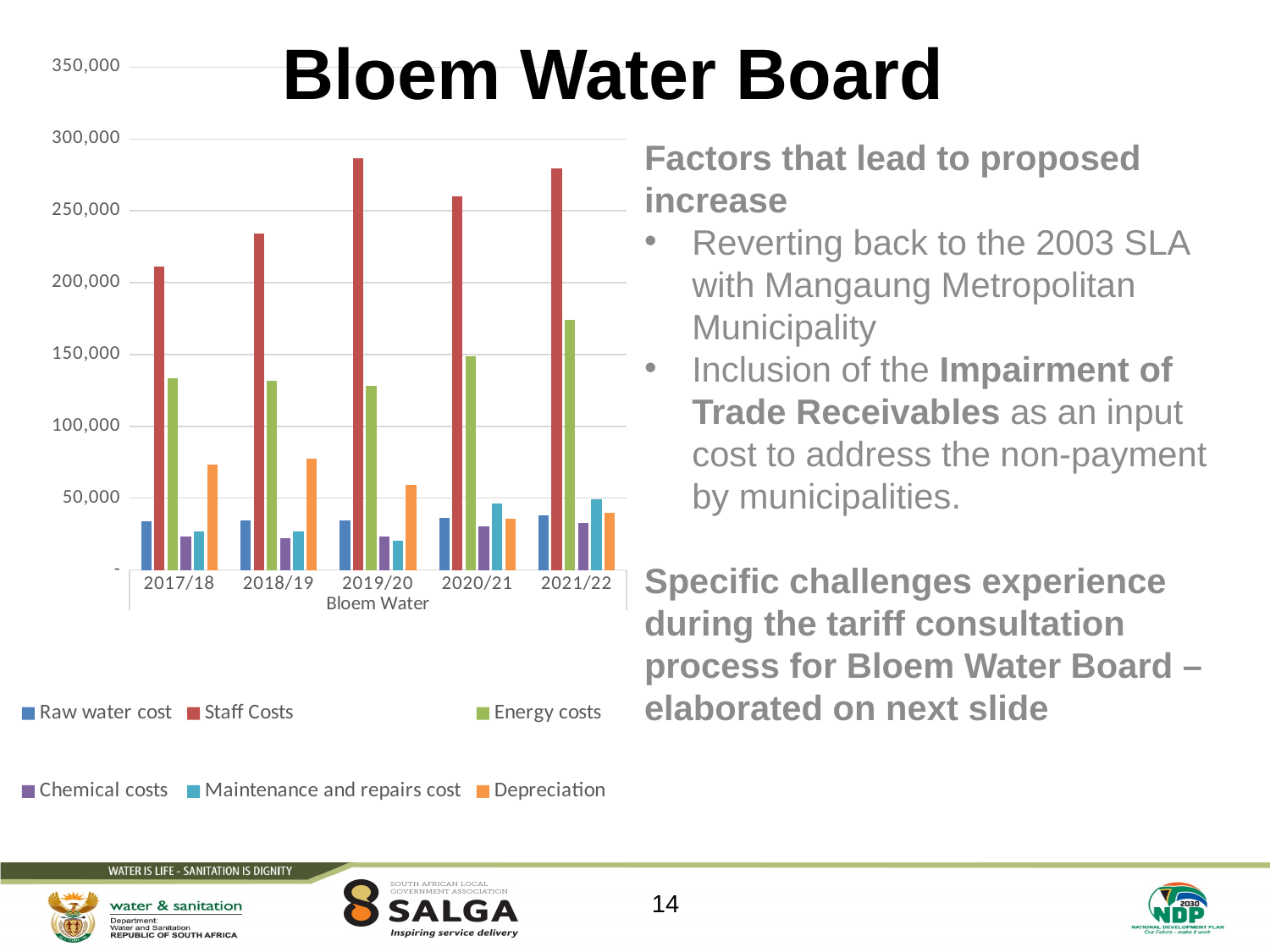
Is the value for Energy costs in 2021/22 greater or less than 150,000? greater Which series has the tallest bar in every year shown? Staff Costs Is the value for Staff Costs in 2019/20 greater or less than 250,000? greater Is the value for Staff Costs in 2017/18 greater or less than 200,000? greater Which is larger: Depreciation in 2018/19 or Depreciation in 2020/21? 2018/19 How many financial years are shown on the x axis of the chart? 5 Which is larger: Energy costs in 2021/22 or Energy costs in 2017/18? 2021/22 In which year are Staff Costs highest? 2019/20 How many series does the chart legend list? 6 What kind of chart is shown on the slide? Bar chart In which year are Staff Costs lowest? 2017/18